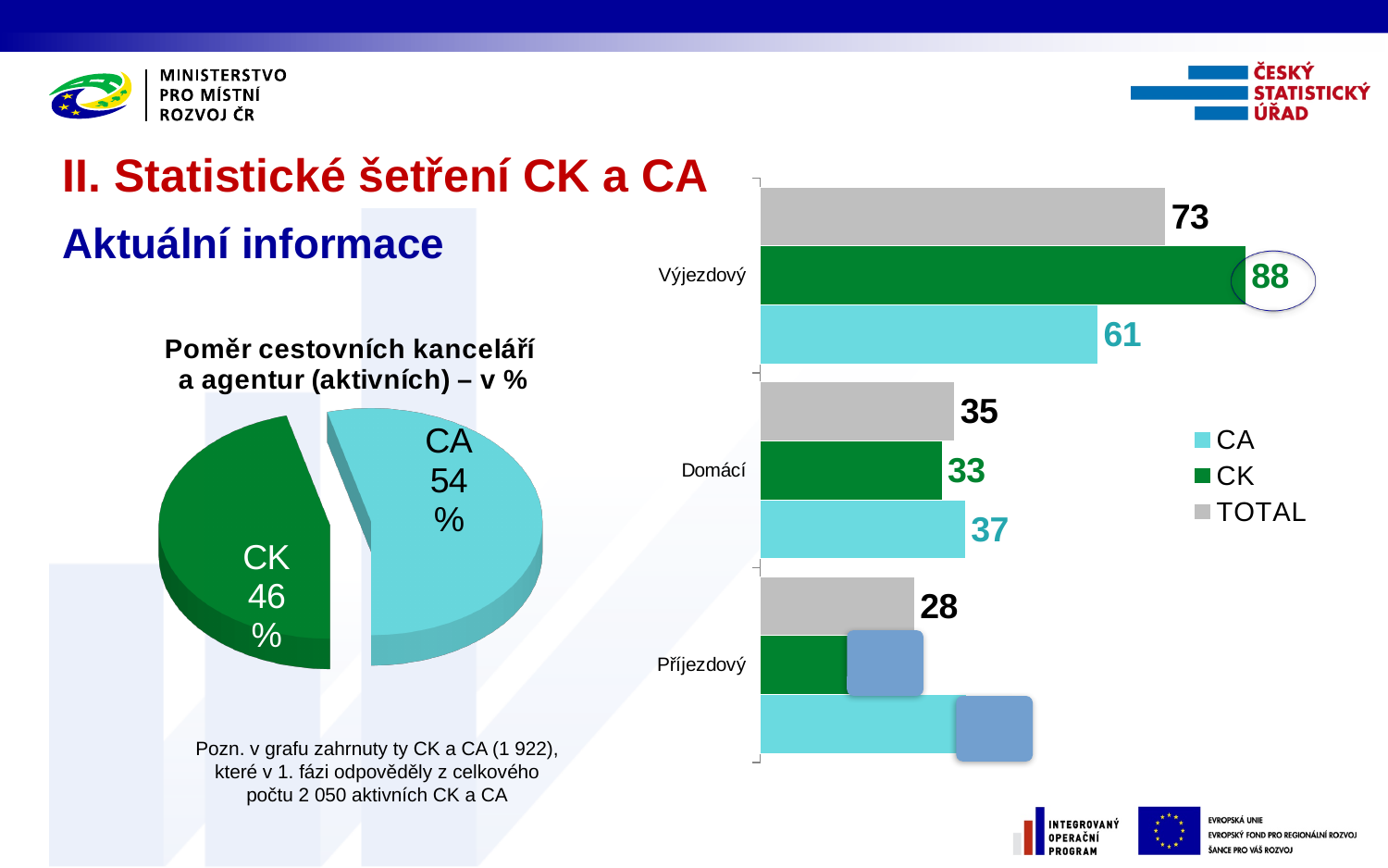
In the bar chart on the right, what is the difference between the CK and CA values for Výjezdový? 27 In the pie chart titled 'Poměr cestovních kanceláří a agentur (aktivních) – v %', what share does CA have? 54 % In the bar chart on the right, what is the CA value for Výjezdový? 61 In the pie chart on the left, which slice is larger, CA or CK? CA How many slices does the pie chart on the left have? 2 What kind of chart is the chart on the right of the slide? Bar chart In the bar chart on the right, what is the CK value for Výjezdový? 88 What kind of chart is the chart on the left of the slide? Pie chart How many series does the legend of the bar chart on the right list? 3 In the bar chart on the right, what is the TOTAL value for Domácí? 35 In the bar chart on the right, which category has the highest TOTAL value? Výjezdový In the pie chart titled 'Poměr cestovních kanceláří a agentur (aktivních) – v %', what share does CK have? 46 %